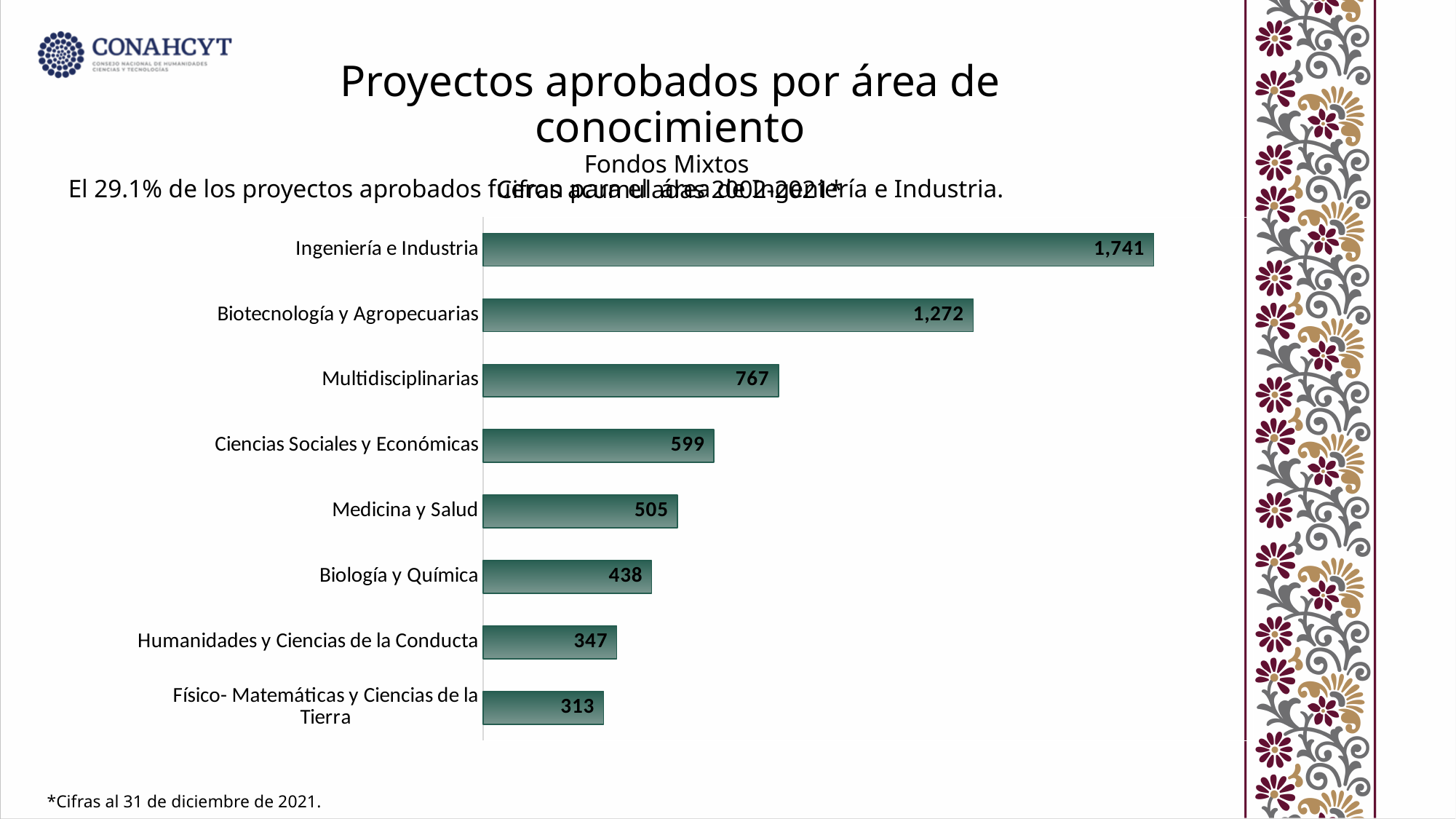
What is the value shown for Medicina y Salud? 505 Which area has the lowest number of approved projects? Físico- Matemáticas y Ciencias de la Tierra What is the value shown for Físico- Matemáticas y Ciencias de la Tierra? 313 What is the difference between the values for Biología y Química and Humanidades y Ciencias de la Conducta? 91 What type of chart is shown on the slide? Bar chart What is the subtitle shown directly below the chart title 'Proyectos aprobados por área de conocimiento'? Fondos Mixtos How many approved projects does the chart show for Ingeniería e Industria? 1,741 Which has a larger value, Ciencias Sociales y Económicas or Medicina y Salud? Ciencias Sociales y Económicas What is the value shown for Multidisciplinarias? 767 What is the difference between the values for Ingeniería e Industria and Biotecnología y Agropecuarias? 469 How many areas of knowledge are shown in the chart? 8 Which area has the highest number of approved projects? Ingeniería e Industria